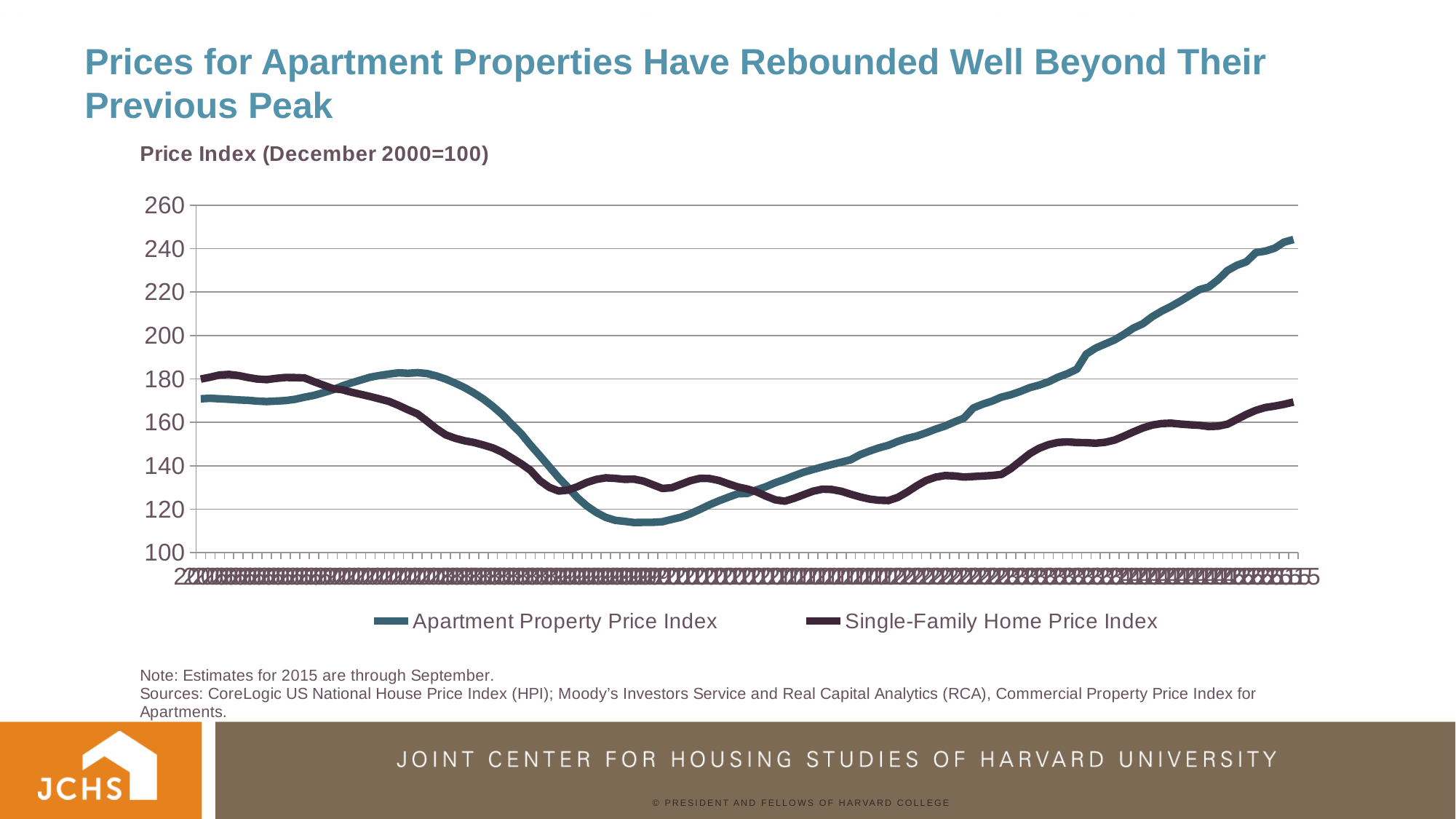
What kind of chart is shown on the slide? line chart Is the lowest point of the Apartment Property Price Index greater or less than 120? less Over the right half of the chart, does the Apartment Property Price Index rise or fall? rise Which series reaches the highest value anywhere on the chart? Apartment Property Price Index At the left end of the chart, which series is higher: the Apartment Property Price Index or the Single-Family Home Price Index? Single-Family Home Price Index How many series does the legend list? 2 Is the final value of the Apartment Property Price Index greater or less than 220? greater What are the two series named in the legend? Apartment Property Price Index; Single-Family Home Price Index At the right end of the chart, which series is higher: the Apartment Property Price Index or the Single-Family Home Price Index? Apartment Property Price Index Is the lowest point of the Single-Family Home Price Index greater or less than 140? less What is the label above the chart describing the y-axis measure? Price Index (December 2000=100)